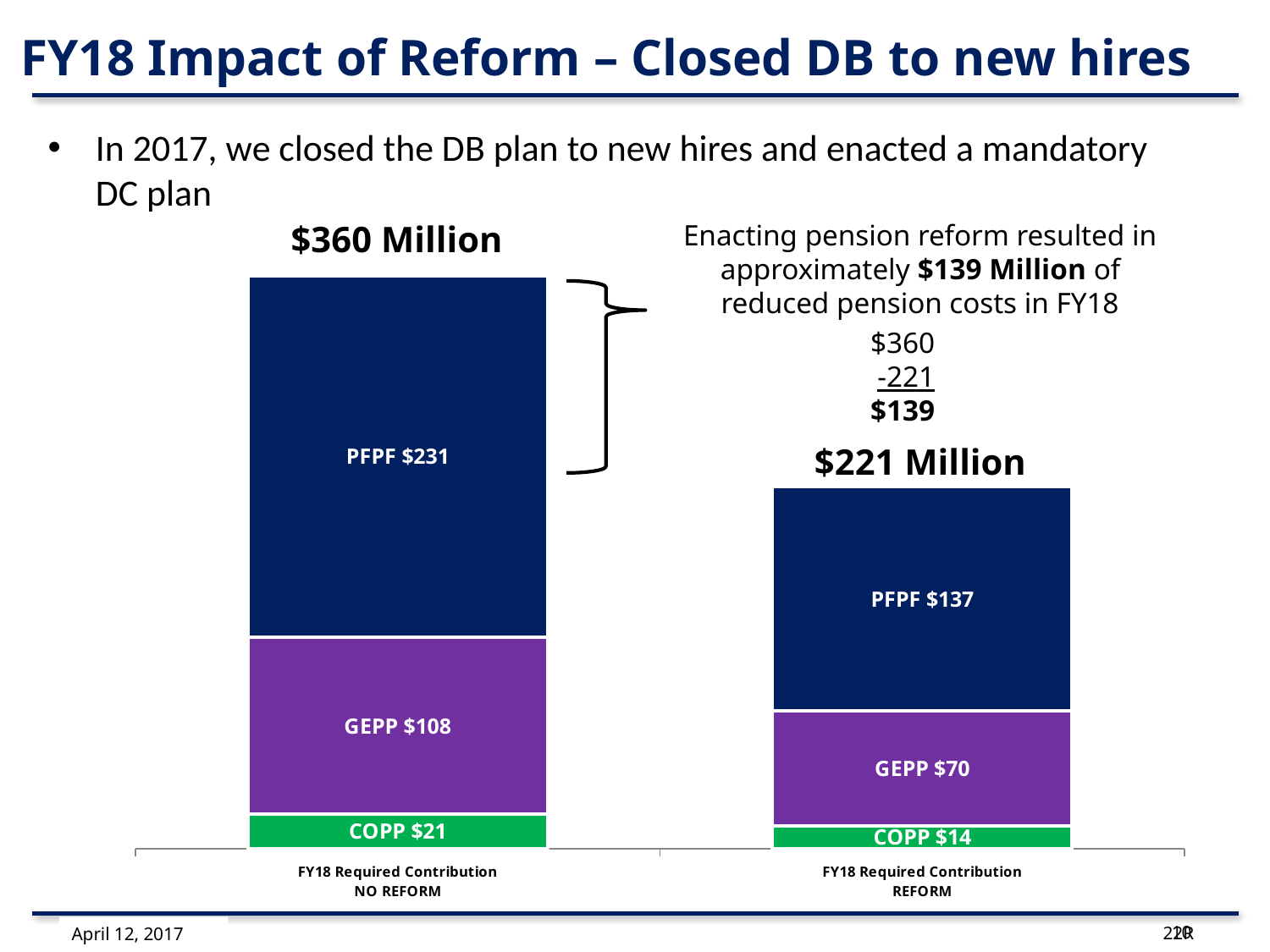
What is the COPP value for the FY18 Required Contribution NO REFORM bar? $21 What is the PFPF value for the FY18 Required Contribution NO REFORM bar? $231 Which segment is the largest in the REFORM bar? PFPF Which bar has the larger total, NO REFORM or REFORM? NO REFORM Which segment is the smallest in the NO REFORM bar? COPP What is the GEPP value for the FY18 Required Contribution REFORM bar? $70 What kind of chart is shown on the slide? Stacked bar chart What is the difference between the GEPP values for NO REFORM and REFORM? $38 What is the total of the FY18 Required Contribution REFORM stacked bar? $221 Million How many bars are shown in the chart? 2 What is the total of the FY18 Required Contribution NO REFORM stacked bar? $360 Million What is the difference between the PFPF values for NO REFORM and REFORM? $94